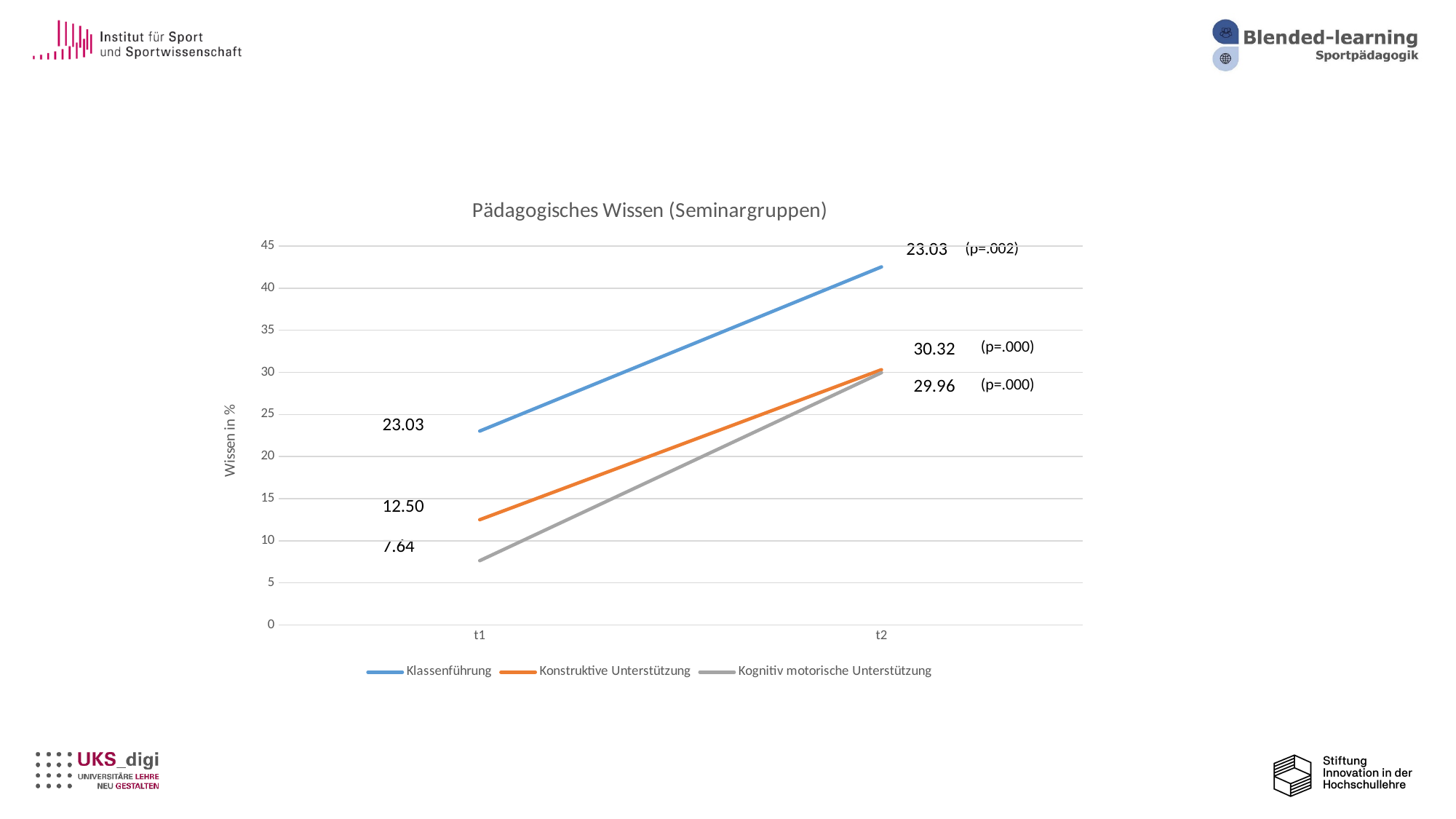
Is the value for Klassenführung at t2 greater or less than 40? greater What is the value for Klassenführung at t1? 23.03 What is the value for Konstruktive Unterstützung at t1? 12.50 What is the value for Konstruktive Unterstützung at t2? 30.32 What is the value for Kognitiv motorische Unterstützung at t1? 7.64 What is the title of the chart? Pädagogisches Wissen (Seminargruppen) How many series does the legend list? 3 Which series has the lowest value at t1? Kognitiv motorische Unterstützung What is the value for Kognitiv motorische Unterstützung at t2? 29.96 How many time points are shown on the x axis? 2 By how much does Konstruktive Unterstützung increase from t1 to t2? 17.82 What kind of chart is shown on the slide? line chart